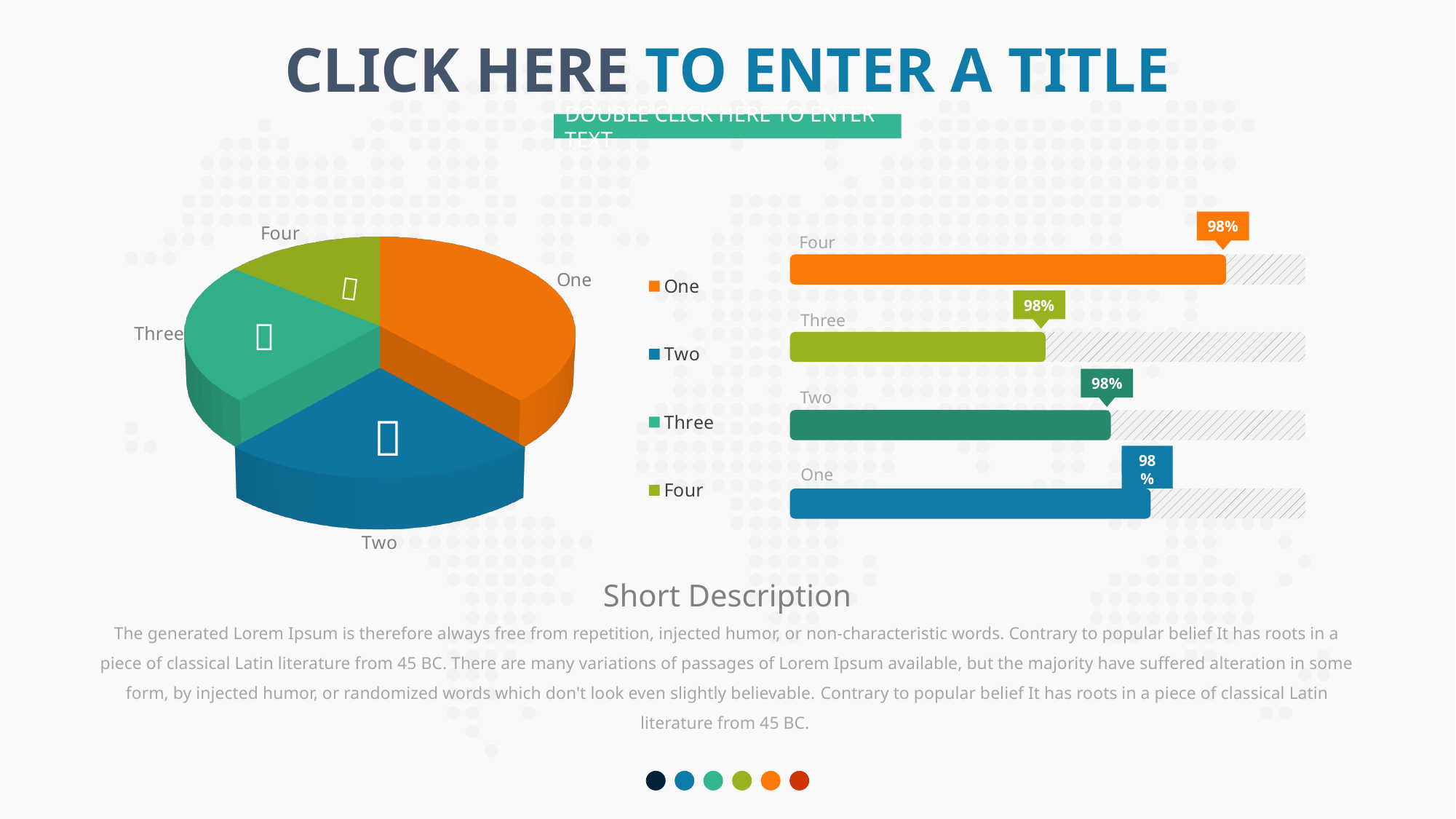
In the bar chart on the right, which category has the shortest bar? Three In the pie chart on the left, what colour is the slice for Two? blue How many entries does the legend of the pie chart on the left list? 4 In the pie chart on the left, which slice is larger, One or Four? One What kind of chart is the chart on the right of the slide? bar chart In the pie chart on the left, which category has the smallest slice? Four What kind of chart is the chart on the left of the slide? pie chart In the bar chart on the right, which bar is longer, Four or Two? Four In the pie chart on the left, which category has the largest slice? One In the bar chart on the right, which category has the longest bar? Four How many slices does the pie chart on the left have? 4 How many bars does the bar chart on the right have? 4